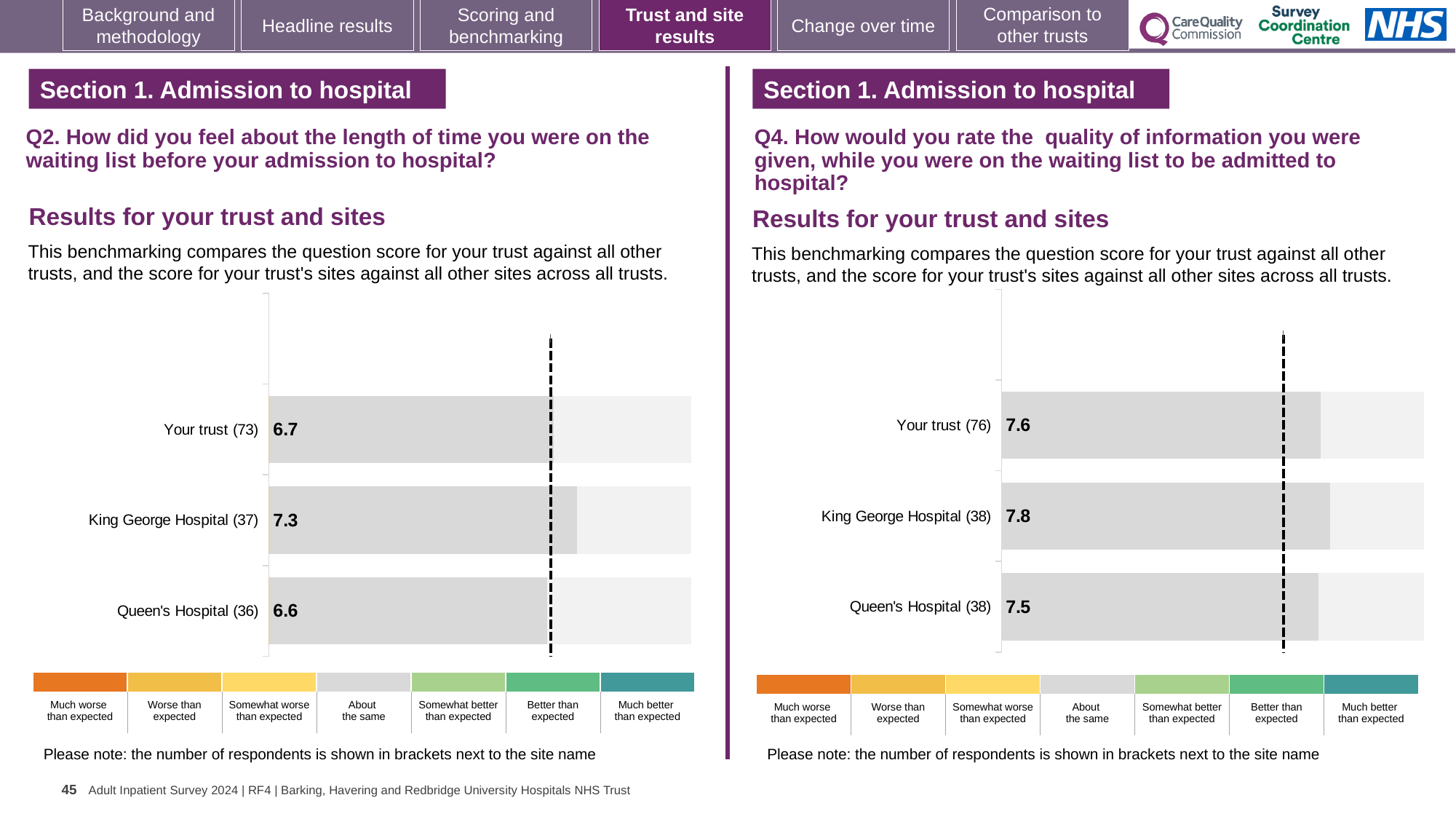
What kind of chart is the Q2 chart (left)? Bar chart On the Q4 chart (right), which site or trust has the highest score? King George Hospital On the Q4 chart (right), what is the difference between the scores for Your trust and Queen's Hospital? 0.1 On the Q4 chart (right), how many bars are plotted? 3 On the Q2 chart (left), how many respondents are shown for Your trust? 73 On the Q4 chart (right), what is the score for King George Hospital? 7.8 On the Q2 chart (left), what is the difference between the scores for King George Hospital and Queen's Hospital? 0.7 On the Q2 chart (left), what is the score for King George Hospital? 7.3 On the Q2 chart (left), which site or trust has the highest score? King George Hospital On the Q4 chart (right), what is the score for Queen's Hospital? 7.5 On the Q2 chart (left), which site or trust has the lowest score? Queen's Hospital On the Q2 chart (left), what is the score for Your trust? 6.7